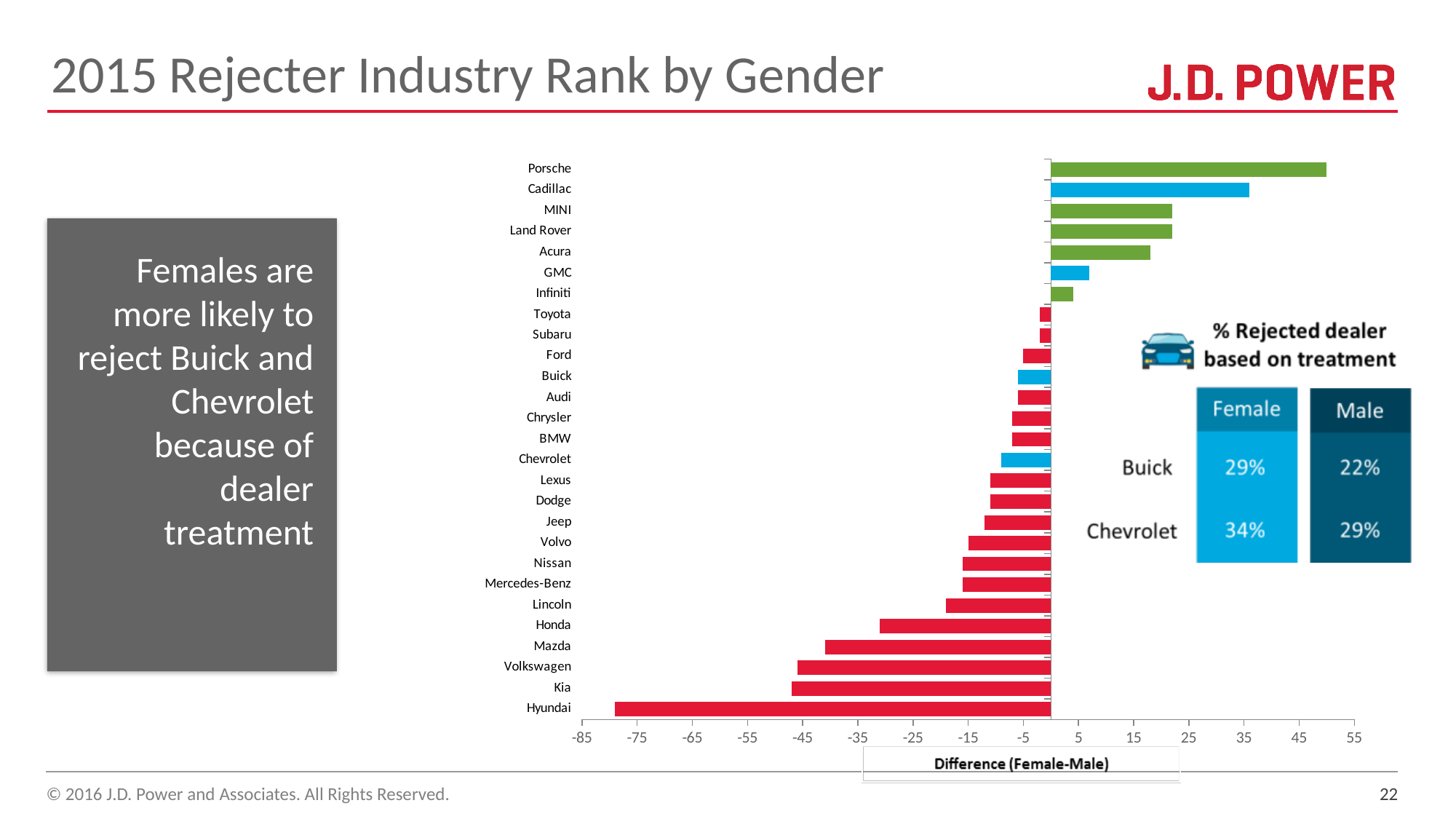
What kind of chart is shown on the slide? bar chart Is the value for Honda greater or less than -25? less What is the title of the x axis of the bar chart? Difference (Female-Male) Is the value for Porsche greater or less than 45? greater Which brand has the lowest value in the bar chart? Hyundai Is the value for Hyundai greater or less than -75? less Which has the lower value, Hyundai or Kia? Hyundai Which brand has the highest value in the bar chart? Porsche How many brands are plotted in the bar chart? 27 Which has the larger value, Porsche or Cadillac? Porsche